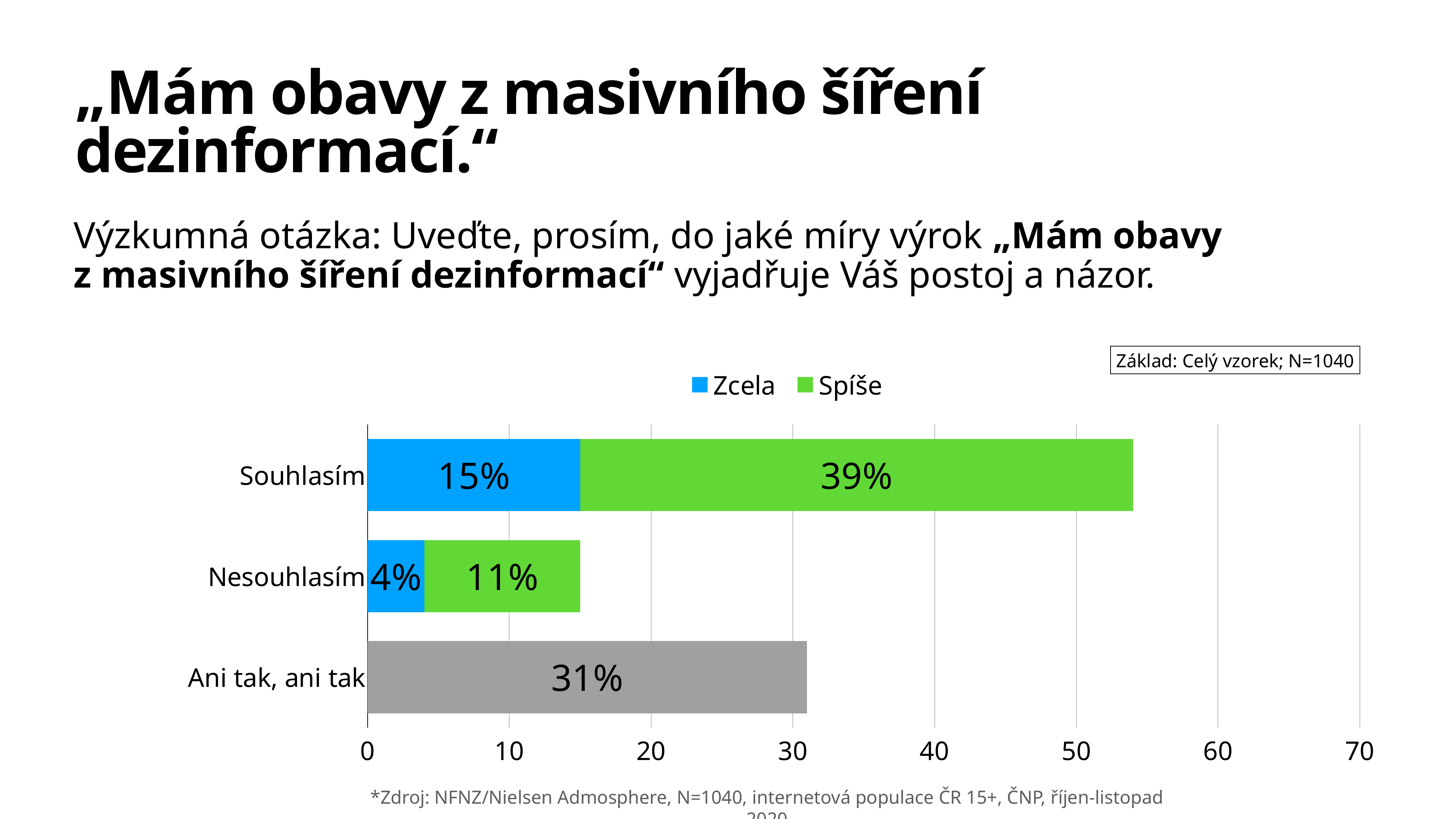
What is the "Spíše" value for "Souhlasím"? 39% What is the "Zcela" value for "Souhlasím"? 15% How many series does the chart legend list? 2 What is the value shown for "Ani tak, ani tak"? 31% What is the "Spíše" value for "Nesouhlasím"? 11% What is the "Zcela" value for "Nesouhlasím"? 4% What is the total of the stacked bar for "Souhlasím"? 54% What is the total of the stacked bar for "Nesouhlasím"? 15% What is the difference between the "Spíše" values for "Souhlasím" and "Nesouhlasím"? 28% Which is larger: the "Zcela" value for "Souhlasím" or the "Zcela" value for "Nesouhlasím"? Souhlasím What kind of chart is shown on the slide? Stacked bar chart How many categories are shown on the vertical axis of the chart? 3